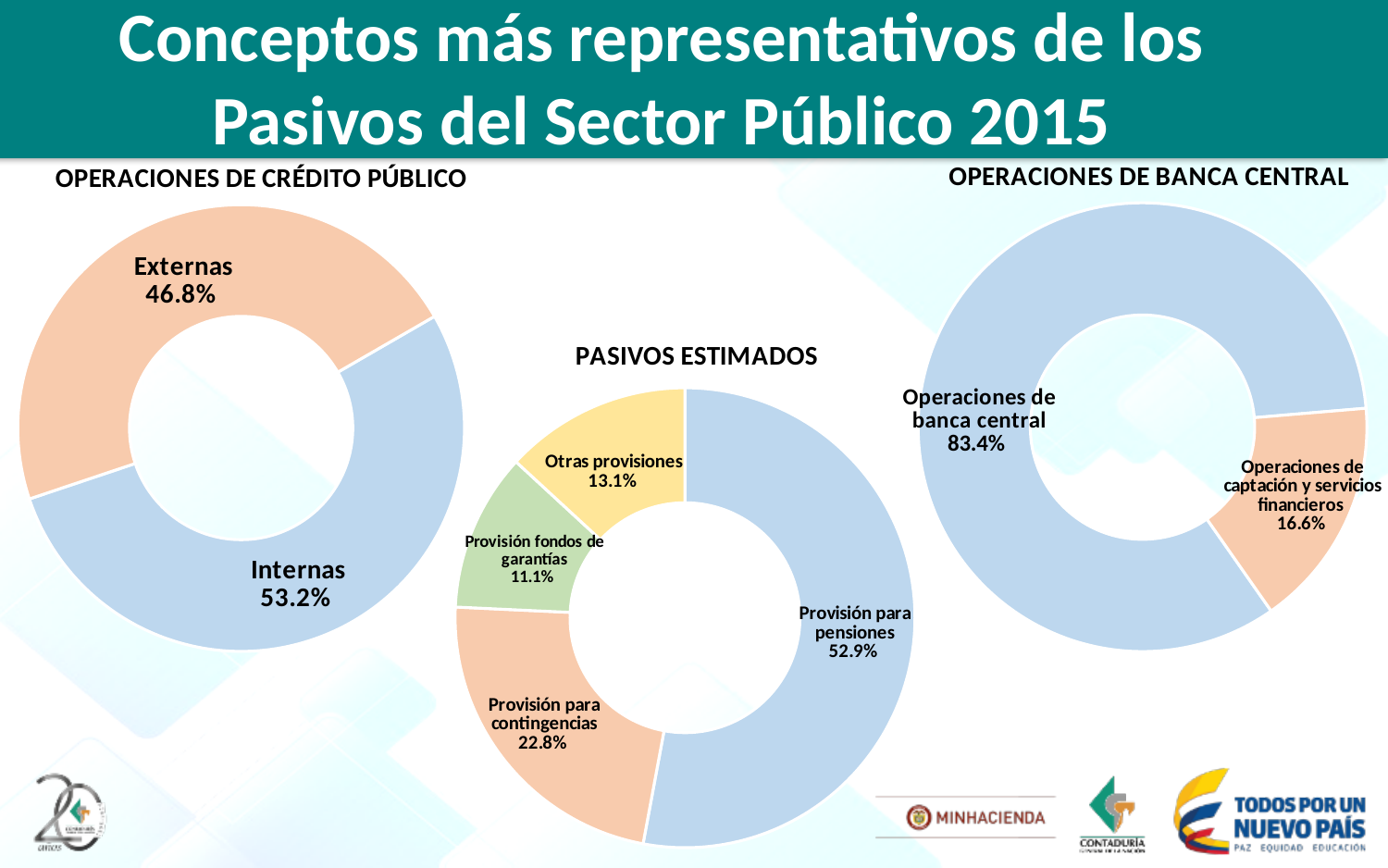
In the OPERACIONES DE CRÉDITO PÚBLICO chart, what is the difference between the Internas and Externas shares? 6.4% In the PASIVOS ESTIMADOS chart, which category has the largest share? Provisión para pensiones What kind of chart is the PASIVOS ESTIMADOS chart? Pie (donut) chart In the PASIVOS ESTIMADOS chart, what is the share for Provisión para pensiones? 52.9% In the OPERACIONES DE CRÉDITO PÚBLICO chart, what is the share for Externas? 46.8% In the PASIVOS ESTIMADOS chart, what is the share for Provisión para contingencias? 22.8% In the OPERACIONES DE BANCA CENTRAL chart, what is the share for Operaciones de banca central? 83.4% In the PASIVOS ESTIMADOS chart, which category has the smallest share? Provisión fondos de garantías In the OPERACIONES DE CRÉDITO PÚBLICO chart, what is the share for Internas? 53.2% In the OPERACIONES DE BANCA CENTRAL chart, what is the share for Operaciones de captación y servicios financieros? 16.6% How many categories are shown in the PASIVOS ESTIMADOS chart? 4 In the OPERACIONES DE CRÉDITO PÚBLICO chart, which slice is larger, Externas or Internas? Internas